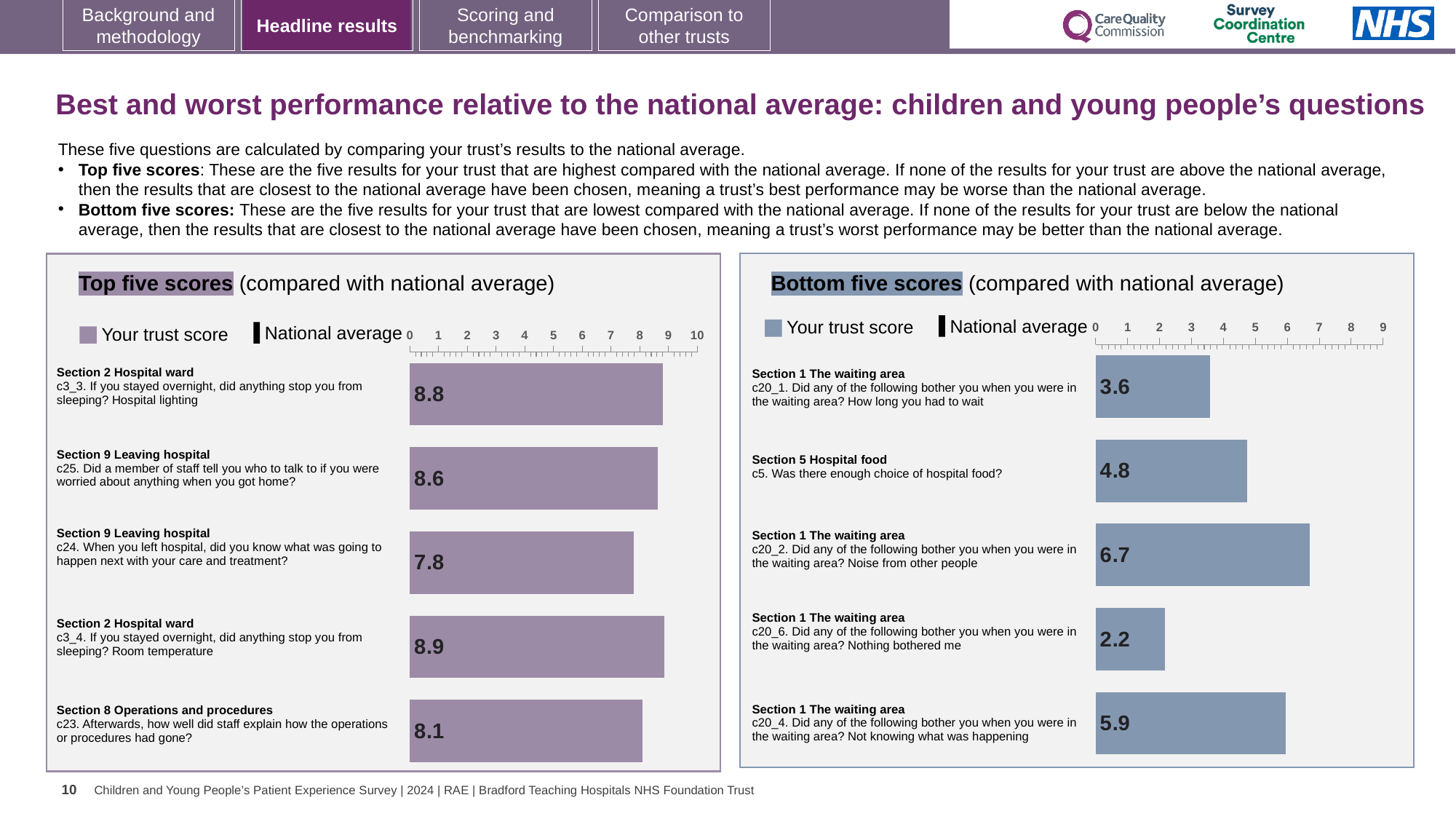
How many questions are shown in the Bottom five scores chart? 5 In the Top five scores chart, which has the larger trust score: c25 (who to talk to if worried when you got home) or c23 (how well staff explained how operations had gone)? c25 In the Bottom five scores chart, which question has the highest trust score? c20_2. Did any of the following bother you when you were in the waiting area? Noise from other people In the Top five scores chart, what is the trust score for c3_3 (hospital lighting stopping you from sleeping)? 8.8 In the Top five scores chart, what is the difference between the trust scores for c3_4 (room temperature) and c24 (knowing what was going to happen next)? 1.1 In the Bottom five scores chart, which question has the lowest trust score? c20_6. Did any of the following bother you when you were in the waiting area? Nothing bothered me In the Top five scores chart, which question has the highest trust score? c3_4. If you stayed overnight, did anything stop you from sleeping? Room temperature In the Bottom five scores chart, what is the trust score for c20_4 (not knowing what was happening in the waiting area)? 5.9 In the Top five scores chart, what is the trust score for c24 (knowing what was going to happen next with your care and treatment)? 7.8 What kind of chart is the Top five scores chart? Bar chart In the Bottom five scores chart, what is the trust score for c5 (enough choice of hospital food)? 4.8 In the Bottom five scores chart, what is the difference between the trust scores for c20_2 (noise from other people) and c20_1 (how long you had to wait)? 3.1